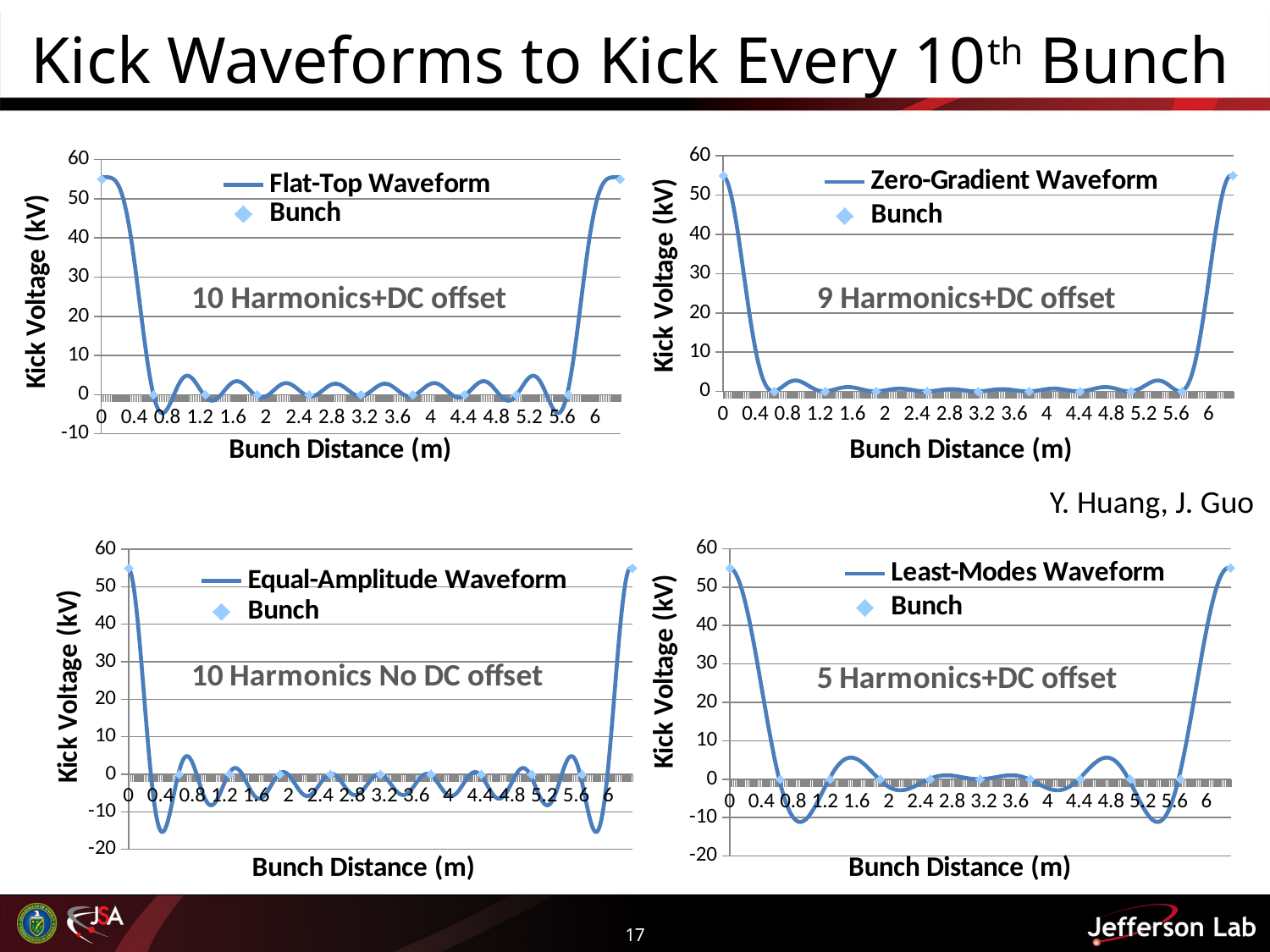
In the top-right chart (Zero-Gradient Waveform), is the kick voltage at bunch distance 3.2 greater or less than 10? less How many series does the legend of the top-right chart (Zero-Gradient Waveform) list? 2 In the top-right chart (Zero-Gradient Waveform), does the kick voltage rise or fall between bunch distance 0 and bunch distance 0.8? fall What kind of chart is the top-left chart titled Flat-Top Waveform? line chart In the top-left chart (Flat-Top Waveform), is the kick voltage at bunch distance 0 greater or less than 50? greater In the bottom-right chart (Least-Modes Waveform), is the kick voltage at bunch distance 1.6 greater or less than 10? less What annotation text is printed inside the bottom-right chart (Least-Modes Waveform)? 5 Harmonics+DC offset In the top-left chart (Flat-Top Waveform), which is larger: the kick voltage at bunch distance 0 or at bunch distance 3.2? bunch distance 0 In the bottom-left chart (Equal-Amplitude Waveform), what are the two legend entries? Equal-Amplitude Waveform and Bunch